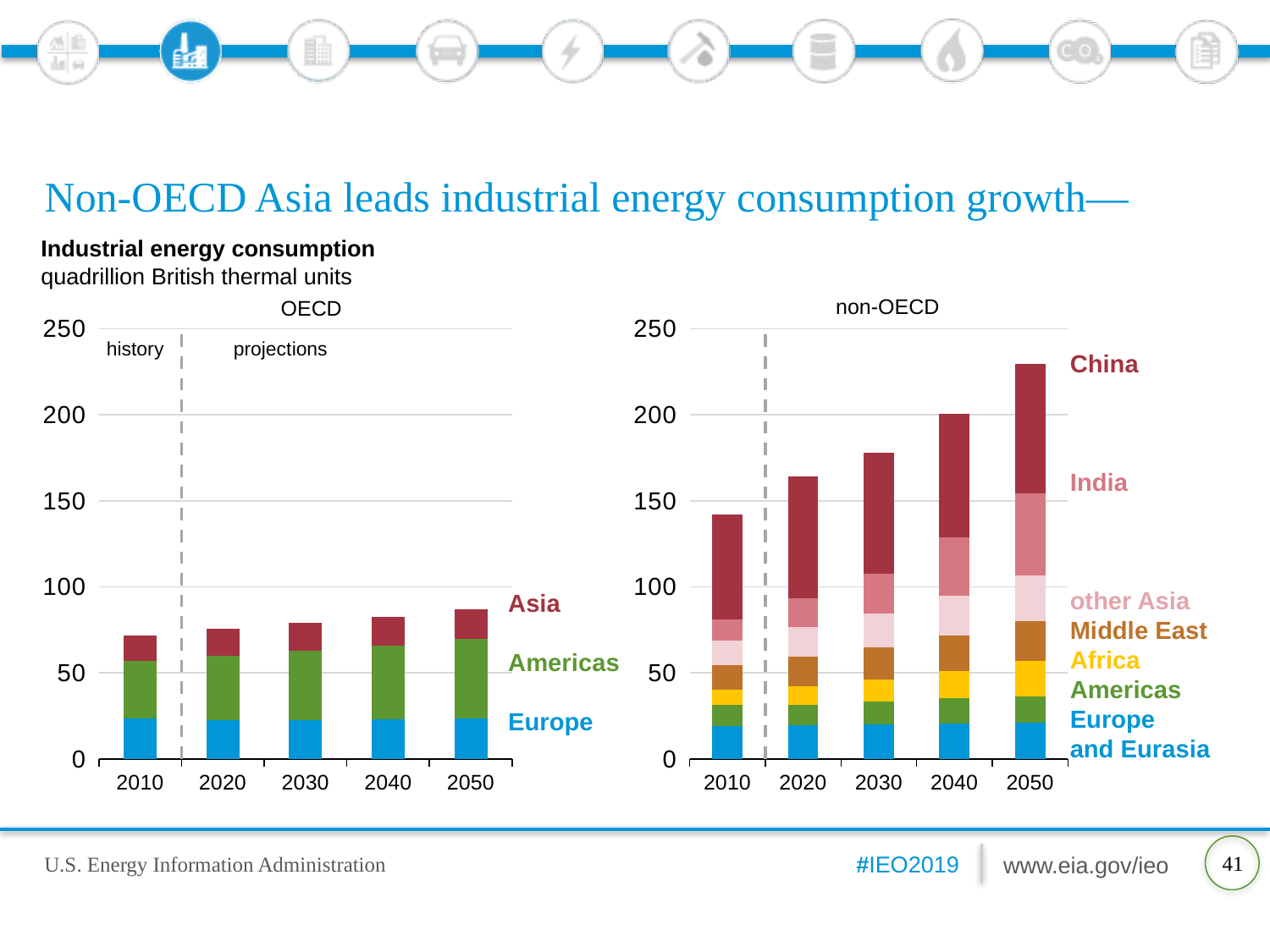
In the non-OECD chart, do total values rise or fall from 2010 to 2050? rise How many series does the non-OECD chart show? 7 In the non-OECD chart, is the total for 2050 greater or less than 200? greater How many series does the OECD chart show? 3 How many years are shown on the x axis of the non-OECD chart? 5 Which is larger in 2050: the total for the OECD chart or the total for the non-OECD chart? non-OECD In the non-OECD chart, which year has the lowest total industrial energy consumption? 2010 In the non-OECD chart, is the total for 2010 greater or less than 150? less In the OECD chart, is the total for 2050 greater or less than 100? less In the non-OECD chart, which series is shown at the top of each stacked bar? China What type of chart is the OECD chart? stacked bar chart In the non-OECD chart, which year has the highest total industrial energy consumption? 2050